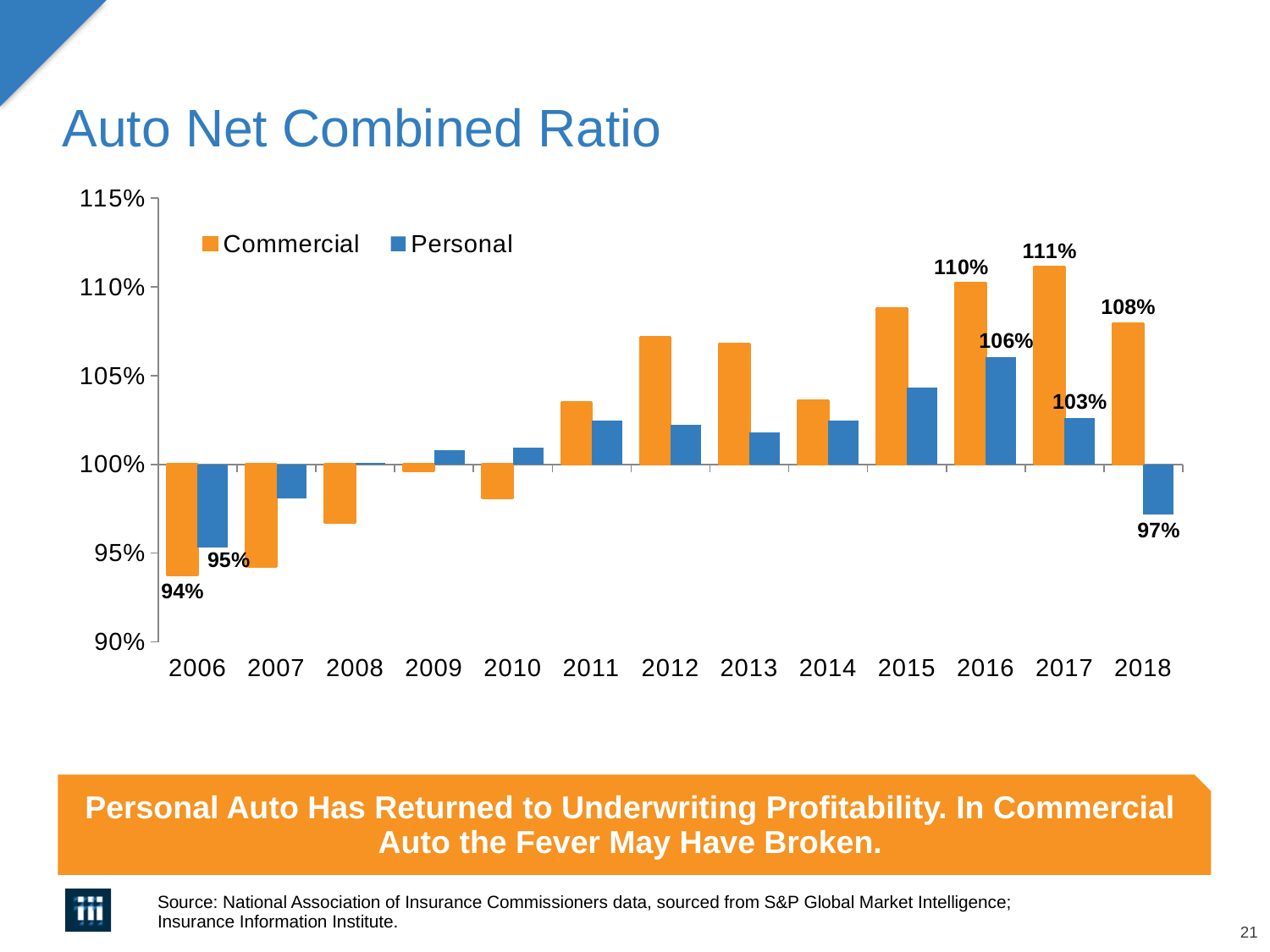
In 2018, which series has the larger value, Commercial or Personal? Commercial Is the Personal value for 2007 greater or less than 100%? less What is the difference between the Commercial and Personal values in 2017? 8 percentage points How many years are shown on the x axis? 13 In which year is the Commercial combined ratio highest? 2017 How many series does the legend list? 2 What kind of chart is shown on the slide? Bar chart What is the Commercial auto net combined ratio for 2017? 111% What is the Personal value shown for 2016? 106% What is the Commercial value shown for 2006? 94% What is the Personal auto net combined ratio for 2018? 97% Is the Commercial value for 2012 greater or less than 105%? greater